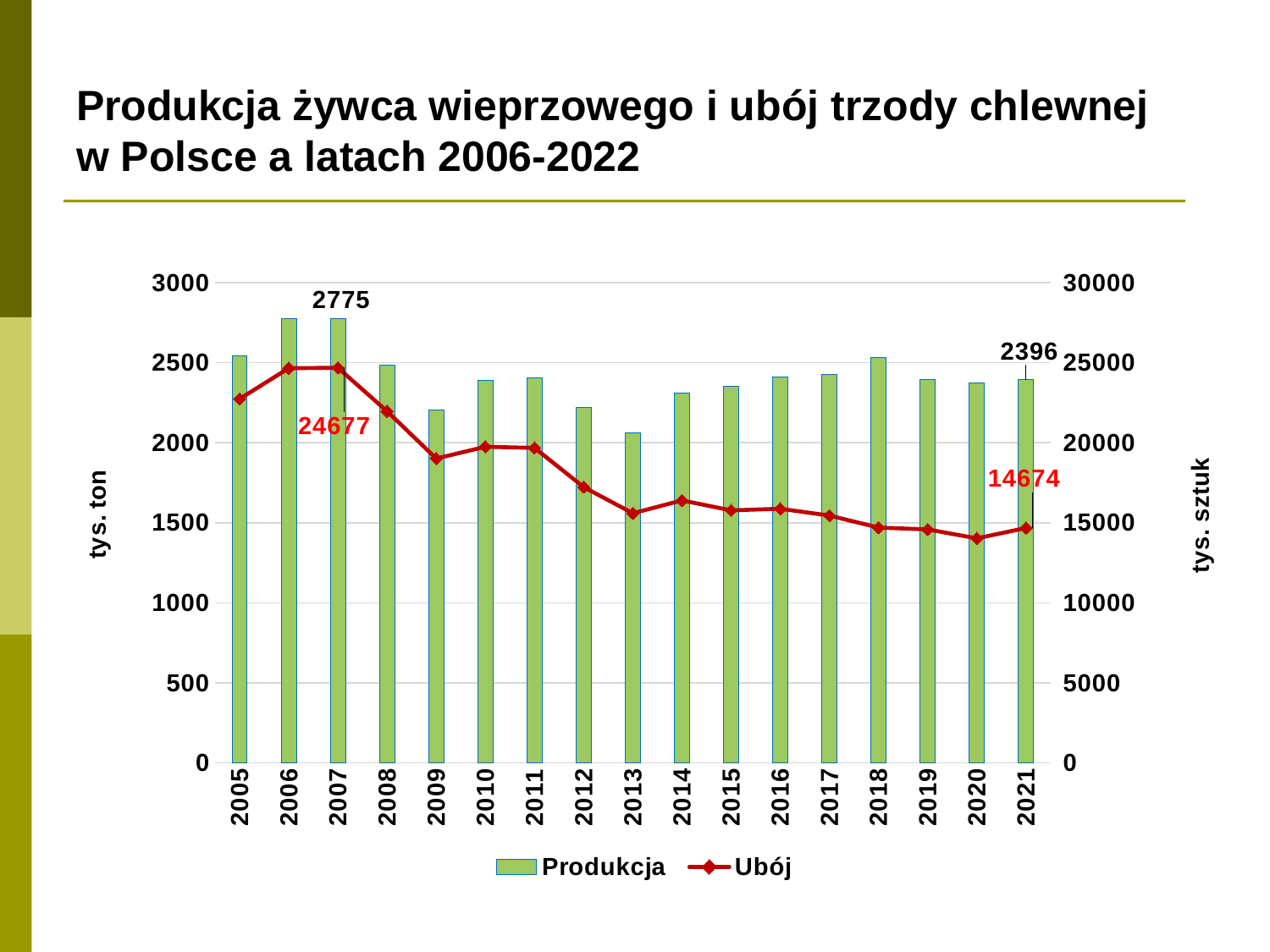
What kind of chart is this? A combined bar and line chart What is the difference between the Ubój values for 2007 and 2021? 10003 Does the Ubój line generally rise or fall from 2007 to 2021? fall How many years are shown on the x axis? 17 How many series does the legend list? 2 What is the Produkcja value for 2021? 2396 What is the Ubój value for 2007? 24677 Is the Produkcja value for 2013 greater or less than 2500? less Which year has the lowest Produkcja bar? 2013 What is the Produkcja value for 2007? 2775 What is the Ubój value for 2021? 14674 By how much did Produkcja fall from 2007 to 2021? 379